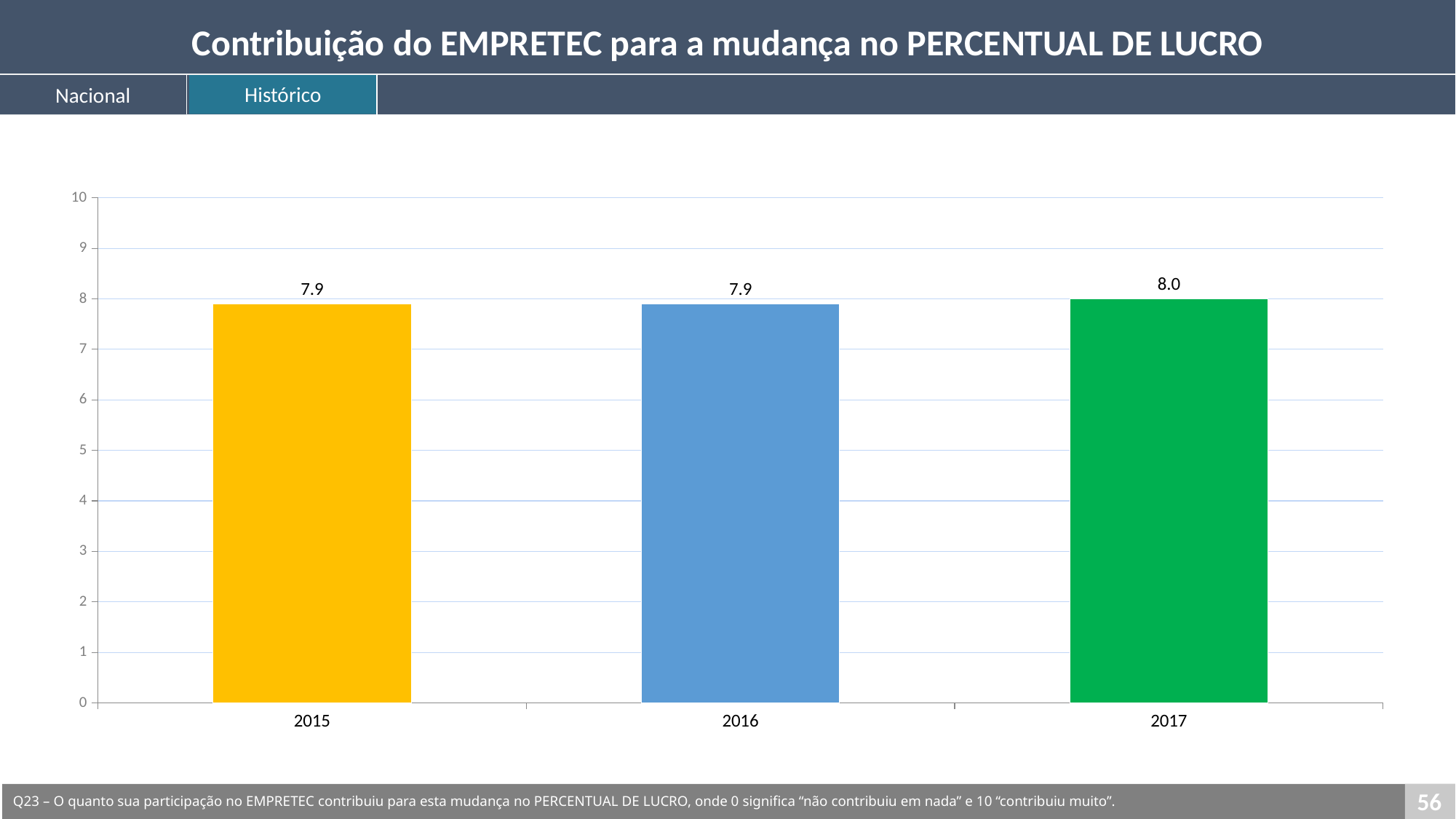
Which year has the highest value? 2017 What is the difference between the values for 2017 and 2015? 0.1 What kind of chart is shown on the slide? bar chart Is the value for 2016 greater or less than 7? greater What is the value for 2015? 7.9 What is the value for 2017? 8.0 What is the maximum value shown on the y axis? 10 Do the values rise or fall from 2015 to 2017? rise What colour is the bar for 2016? blue Is the value for 2017 greater or less than 9? less How many years are shown on the x axis? 3 What is the value for 2016? 7.9